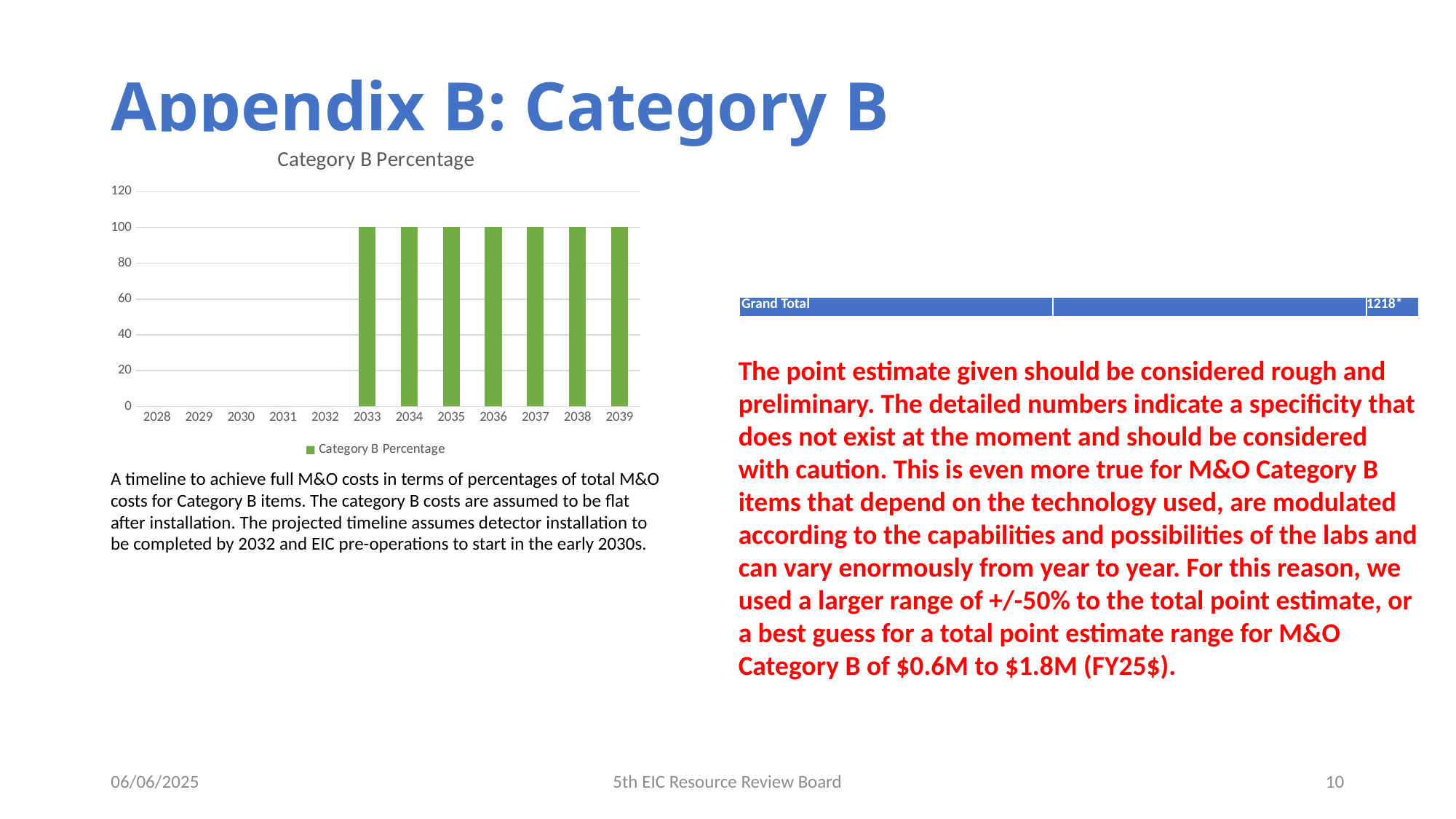
Which is larger, the value for 2032 or the value for 2033? 2033 Is the value for 2037 greater or less than 80? greater What is the Category B Percentage value for 2030? 0 Do the values rise or fall along the x axis from 2028 to 2039? rise What kind of chart is shown on the slide? bar chart How many series does the chart legend list? 1 What is the first year in which the Category B Percentage reaches 100? 2033 What is the difference between the value for 2033 and the value for 2032? 100 What is the title of the chart? Category B Percentage In how many years does the chart show a bar at 100? 7 How many years are shown on the x axis of the chart? 12 What is the Category B Percentage value for 2035? 100